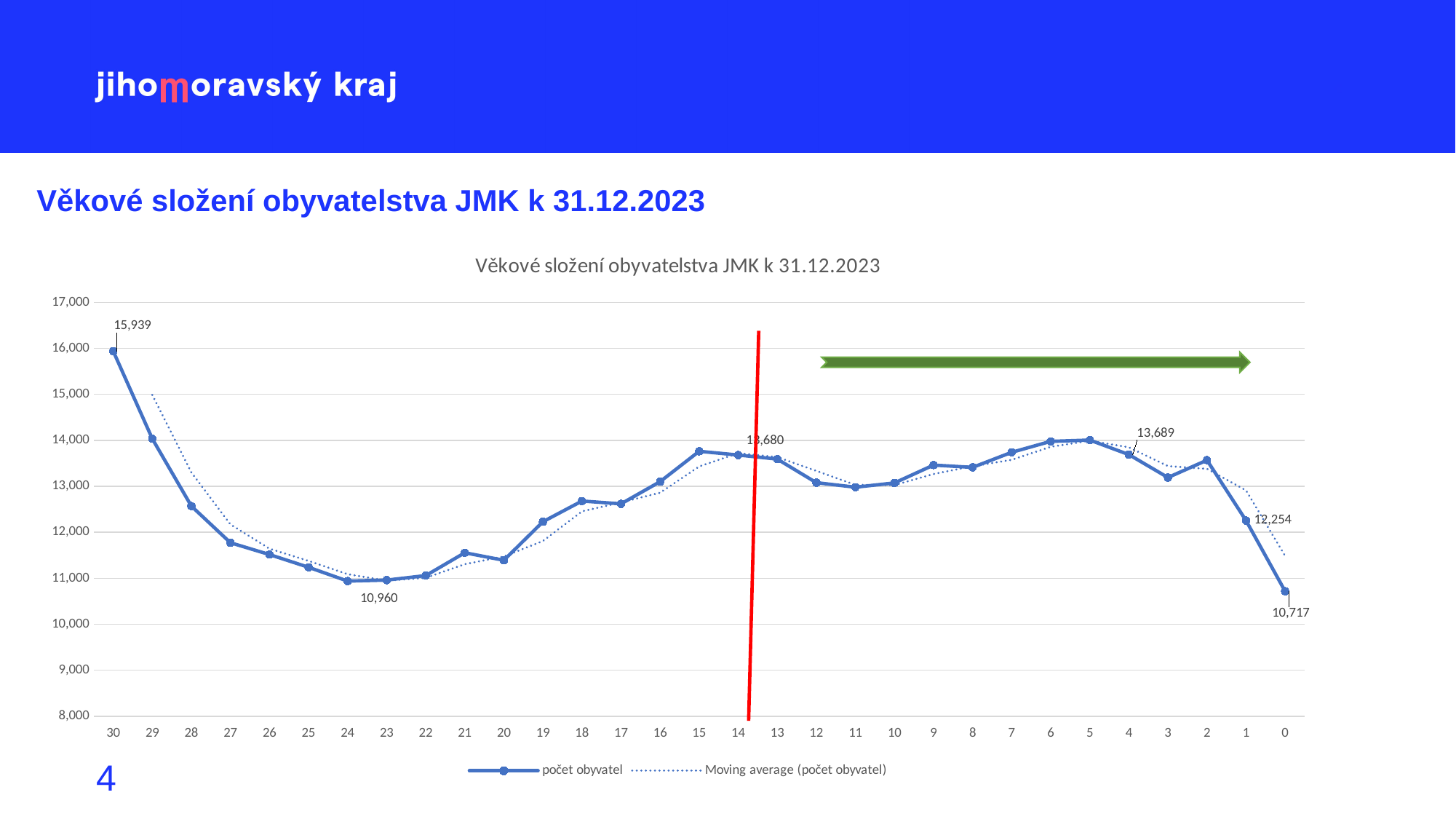
What kind of chart is shown on the slide? line chart What is the value for age 0 in the chart? 10,717 Is the value for age 6 greater or less than 13,000? greater How many series does the legend list? 2 Which age category has the lowest value in the chart? 0 Which is larger, the value for age 4 or the value for age 1? age 4 Which age category has the highest value in the chart? 30 What is the value for age 1 in the chart? 12,254 What is the value for age 30 in the chart? 15,939 What is the difference between the values for age 30 and age 0? 5,222 What is the value for age 4 in the chart? 13,689